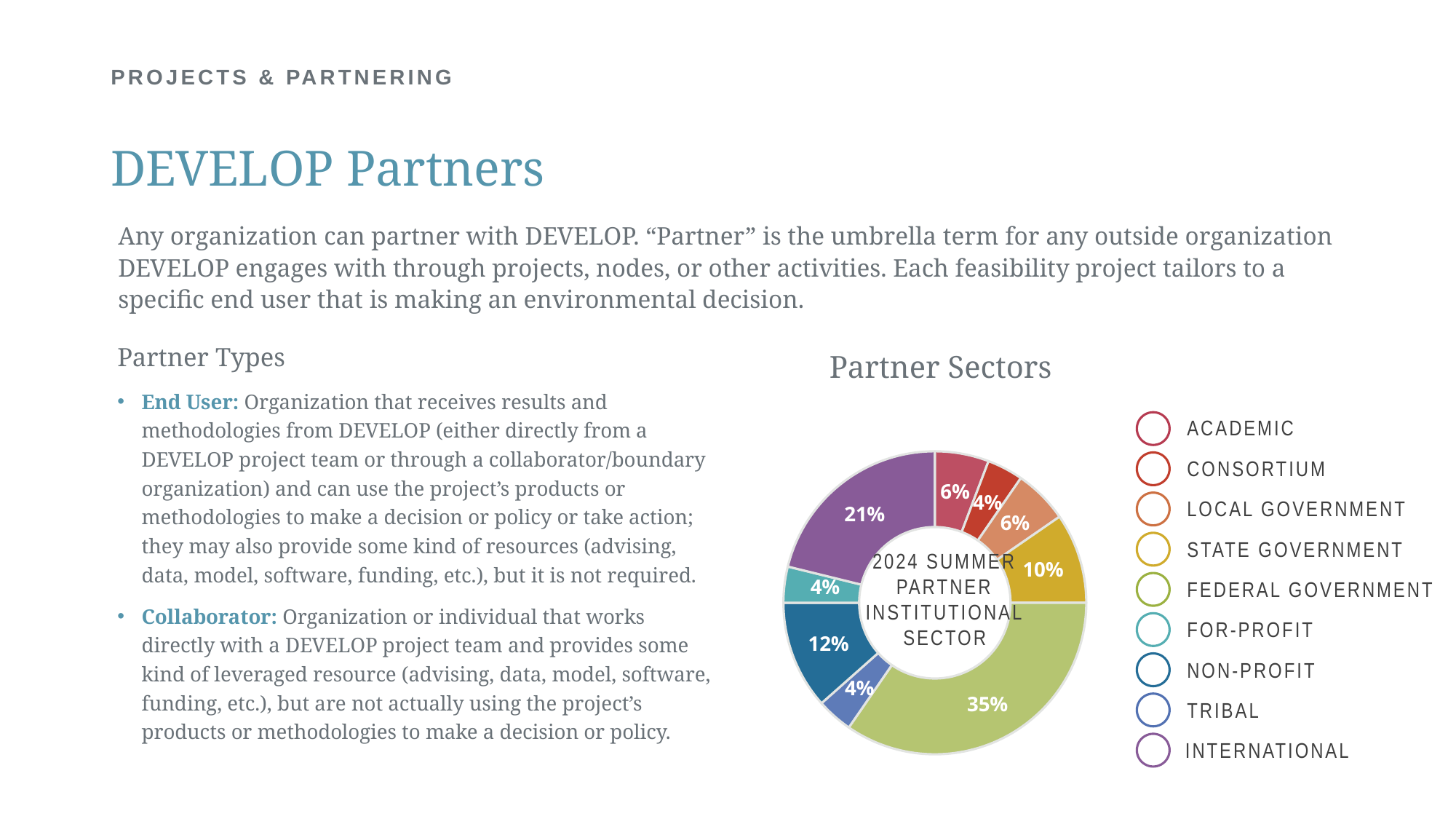
What percentage of the Partner Sectors chart is International? 21% In the Partner Sectors chart, what is the difference between the Federal Government share and the International share? 14% What percentage of the Partner Sectors chart is Academic? 6% What percentage of the Partner Sectors chart is State Government? 10% How many sectors are listed in the legend of the Partner Sectors chart? 9 In the Partner Sectors chart, what is the difference between the State Government share and the Consortium share? 6% What percentage of the Partner Sectors chart is Federal Government? 35% What text appears in the center of the Partner Sectors chart? 2024 SUMMER PARTNER INSTITUTIONAL SECTOR In the Partner Sectors chart, which is larger: International or Non-Profit? International Which sector has the largest share in the Partner Sectors chart? Federal Government What percentage of the Partner Sectors chart is Non-Profit? 12% What type of chart is shown under the title "Partner Sectors"? Doughnut chart